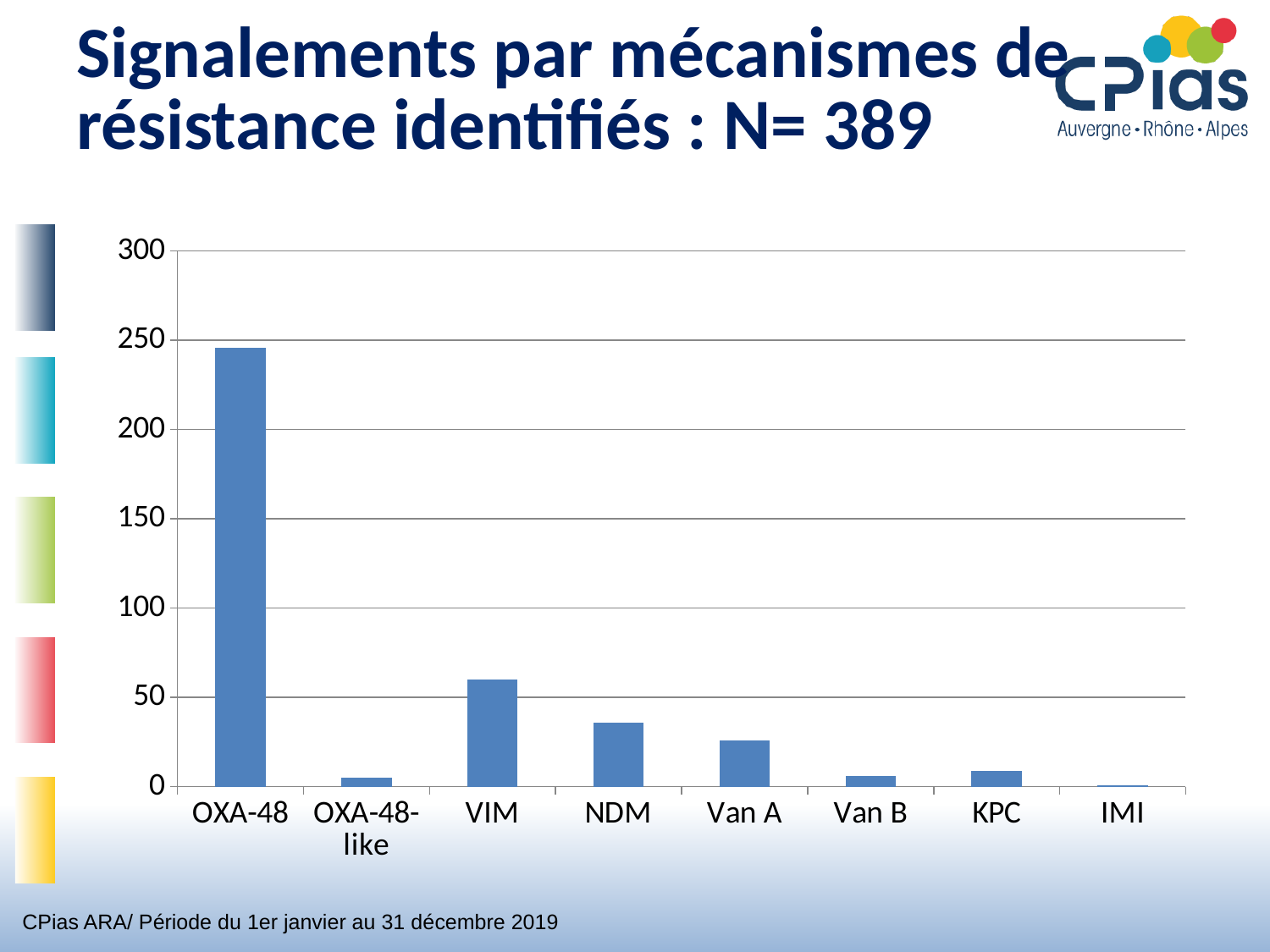
Which has a larger value, NDM or Van A? NDM Is the value for Van A greater or less than 50? less Is the value for OXA-48 greater or less than 200? greater Which resistance mechanism has the highest number of signalements in the chart? OXA-48 Is the value for VIM greater or less than 50? greater How many resistance mechanisms (categories) are shown on the x axis of the chart? 8 What kind of chart is shown on the slide? bar chart Which resistance mechanism has the lowest number of signalements in the chart? IMI What is the total number of signalements (N) stated in the slide title? 389 Which has a larger value, VIM or NDM? VIM